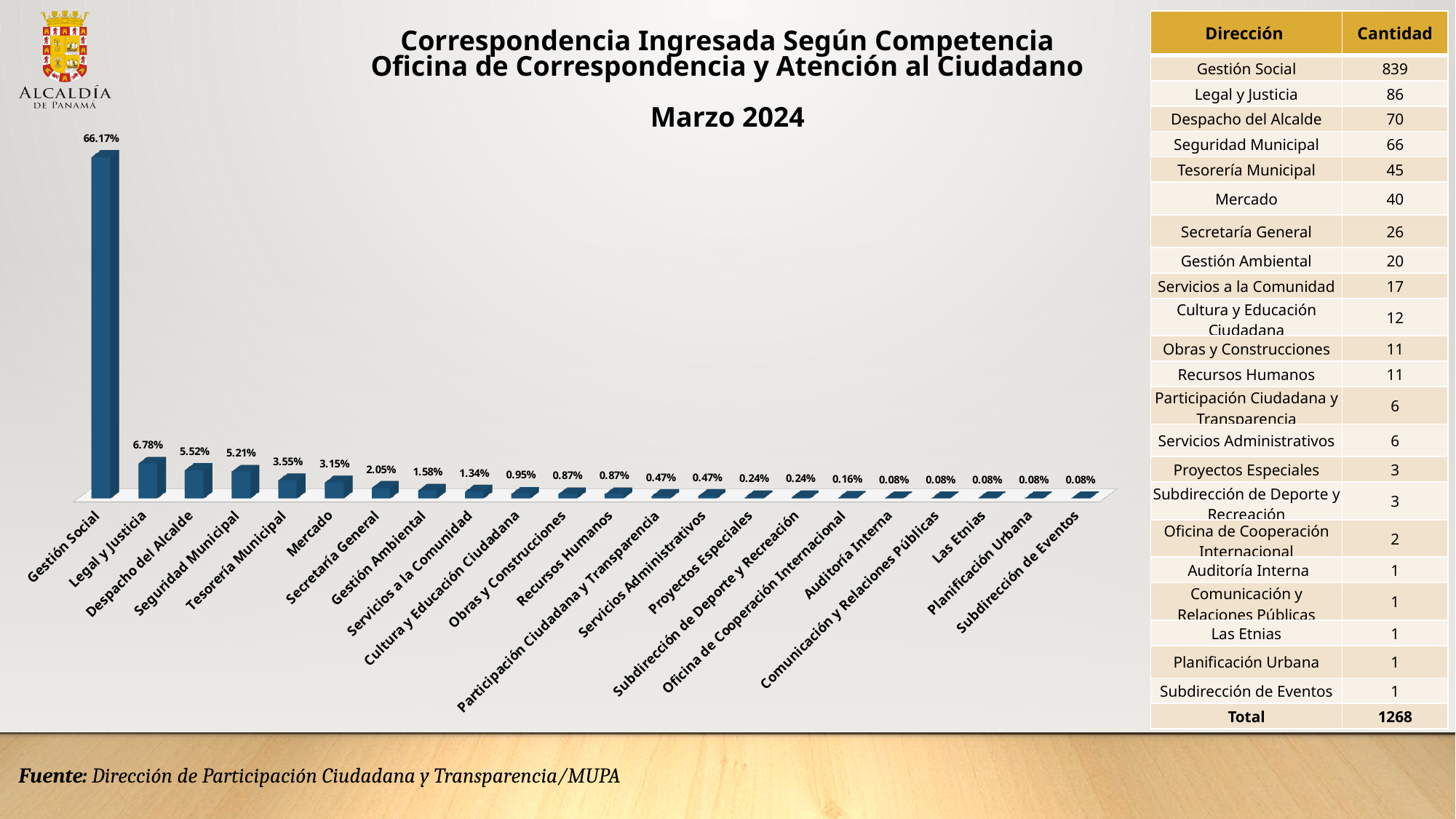
What is the value for Gestión Social? 66.17% Which is larger, the value for Tesorería Municipal or the value for Mercado? Tesorería Municipal Which category has the highest value? Gestión Social What is the value for Gestión Ambiental? 1.58% What kind of chart is this? Bar chart What month and year does the chart title refer to? Marzo 2024 What is the difference between the values for Gestión Social and Legal y Justicia? 59.39% Do the values rise or fall from left to right along the x axis? Fall What is the value for Legal y Justicia? 6.78% What is the difference between the values for Despacho del Alcalde and Seguridad Municipal? 0.31% How many categories are shown on the x axis? 22 What is the value for Mercado? 3.15%